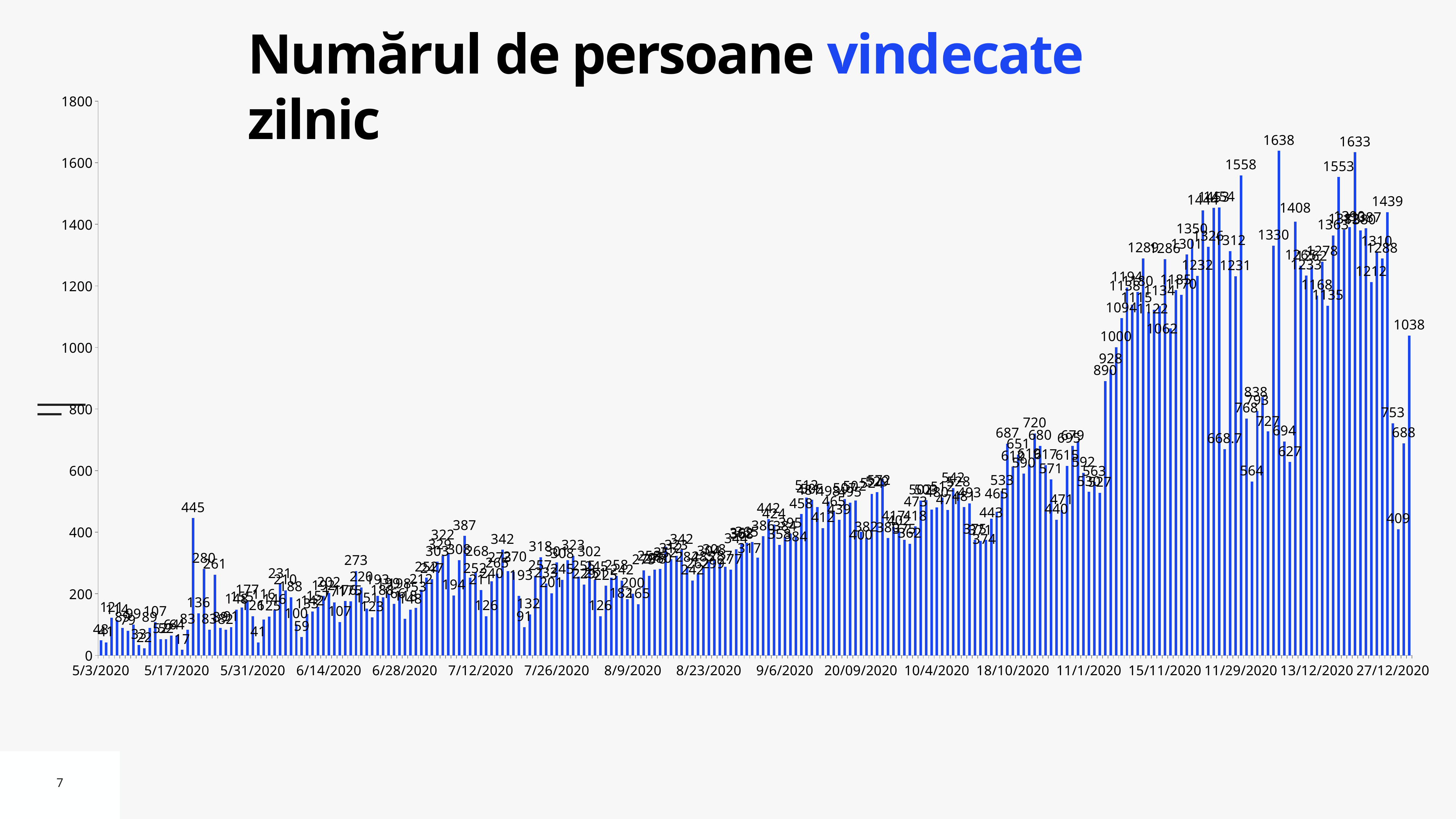
What is the difference between the two tallest bars, labelled 1638 and 1633? 5 What is the maximum value shown on the vertical axis? 1800 Is the bar labelled 409 near the right end of the chart greater or less than 600? less What is the title of the chart? Numărul de persoane vindecate zilnic What kind of chart is shown on the slide? bar chart Is the highest bar on the chart greater or less than 1600? greater Overall, do the values rise or fall from May 2020 to December 2020? rise What is the difference between the bar labelled 1558 and the last bar labelled 1038? 520 What is the value of the last (rightmost) bar on the chart? 1038 What is the highest value labelled on the chart? 1638 Which is larger, the bar labelled 1638 or the bar labelled 1558? 1638 What is the highest value labelled among the bars in May 2020 (between 5/17/2020 and 5/31/2020)? 445